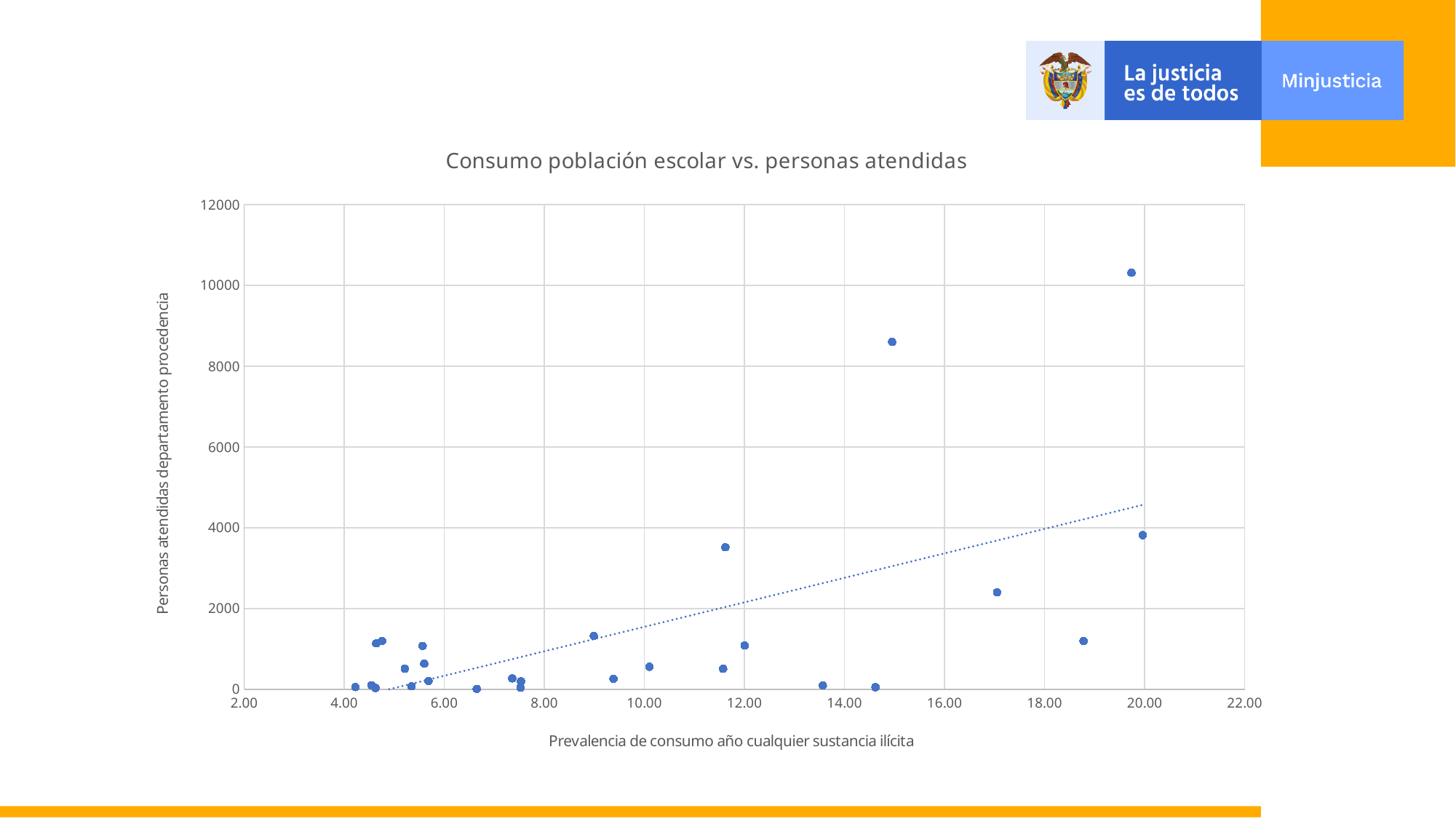
Does the dotted trend line rise or fall as the x value increases? Rises Is the y value of the point near x = 14.60 greater or less than 2000? less Is the x value of the highest point on the chart greater or less than 18.00? greater What is the title of the chart? Consumo población escolar vs. personas atendidas Is the y value of the second-highest point (near x = 15.00) greater or less than 8000? greater What is the maximum value shown on the vertical axis? 12000 What is the label of the horizontal axis? Prevalencia de consumo año cualquier sustancia ilícita What kind of chart is shown on the slide? Scatter chart